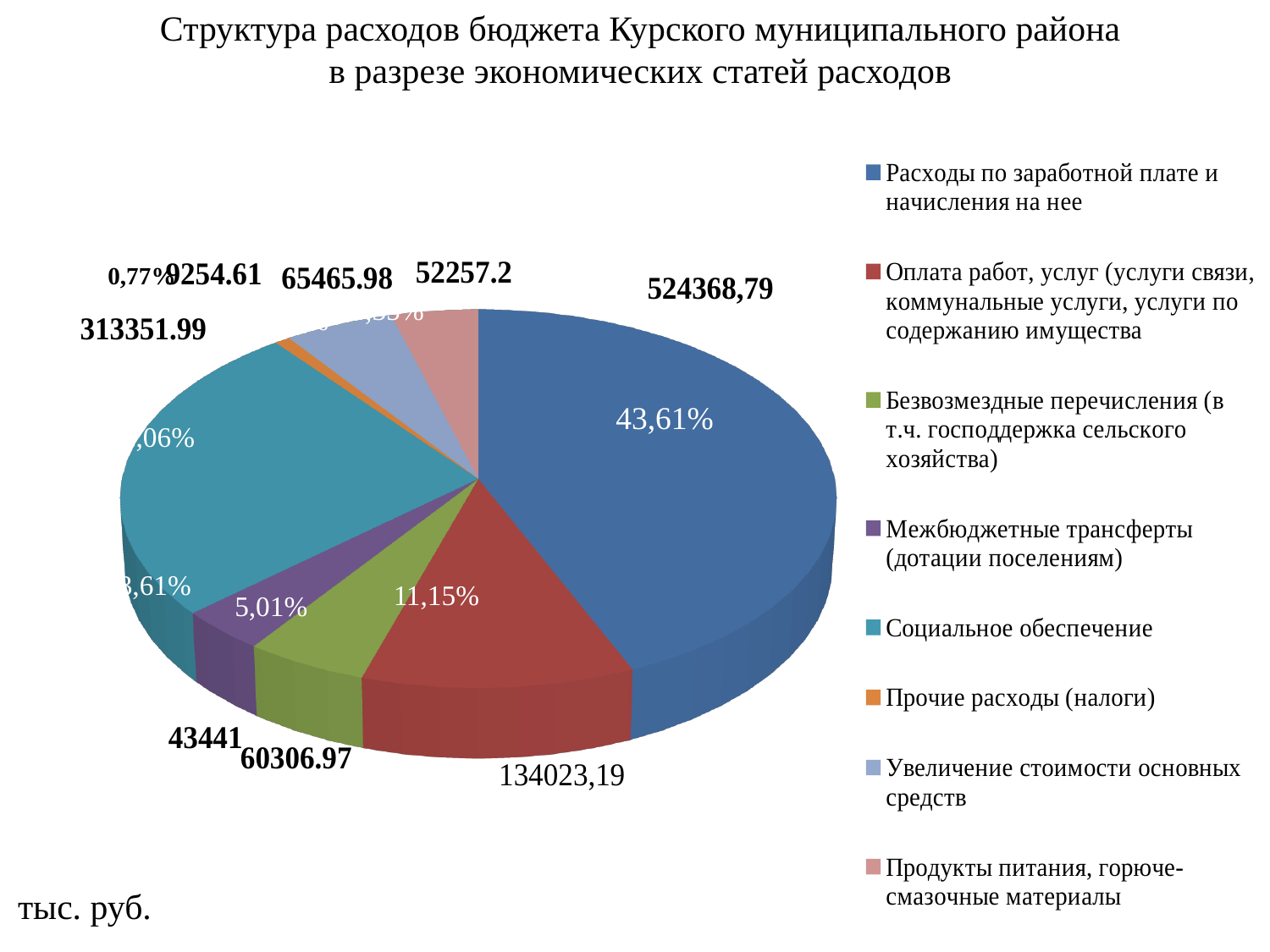
What share of the pie does «Оплата работ, услуг» take? 11,15% In what units are the values on the chart given, according to the note on the slide? тыс. руб. What kind of chart is shown on the slide? pie chart What share of the pie does «Безвозмездные перечисления» take? 5,01% What is the value shown for «Расходы по заработной плате и начисления на нее»? 524368,79 Which is larger: «Социальное обеспечение» or «Оплата работ, услуг»? Социальное обеспечение Which category has the largest slice of the pie? Расходы по заработной плате и начисления на нее Which category has the smallest slice of the pie? Прочие расходы (налоги) What share of the pie does «Расходы по заработной плате и начисления на нее» take? 43,61% How many expense categories does the legend list? 8 What is the value shown for «Оплата работ, услуг»? 134023,19 What is the value shown for «Социальное обеспечение»? 313351.99